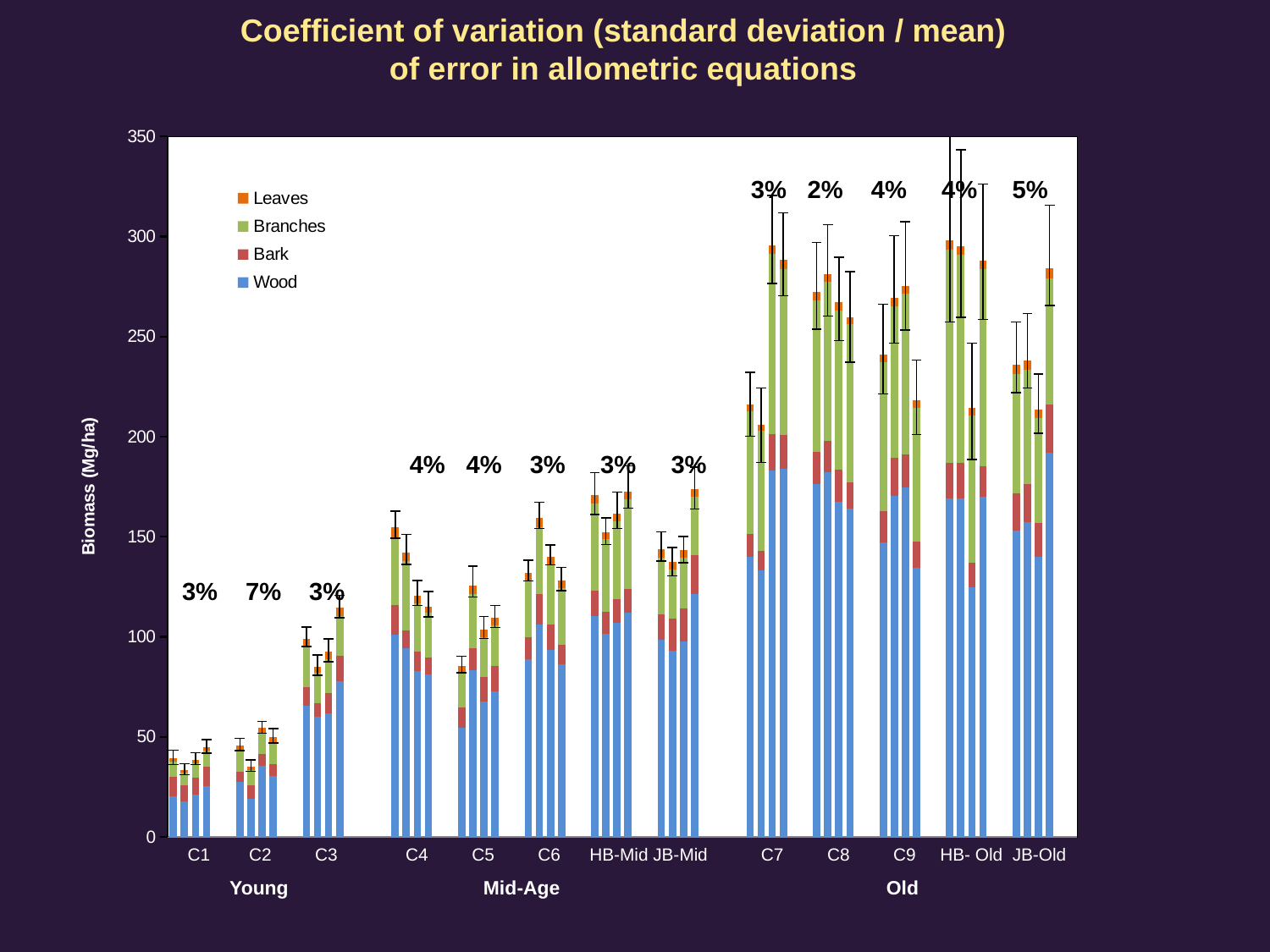
What kind of chart is shown on the slide? bar chart What is the title of the y axis? Biomass (Mg/ha) What coefficient of variation percentage is printed above the JB-Old group? 5% Which site group has the highest coefficient of variation percentage printed above it? C2 Is the biomass of the tallest bar in the C1 group greater or less than 50? less How many site categories are labelled along the x axis? 13 What coefficient of variation percentage is printed above the C8 group? 2% What coefficient of variation percentage is printed above the C2 group? 7% How many series does the legend list? 4 Is the biomass of the tallest bar in the C7 group greater or less than 250? greater Which group has taller biomass bars, C1 or C3? C3 Which site group has the lowest coefficient of variation percentage printed above it? C8